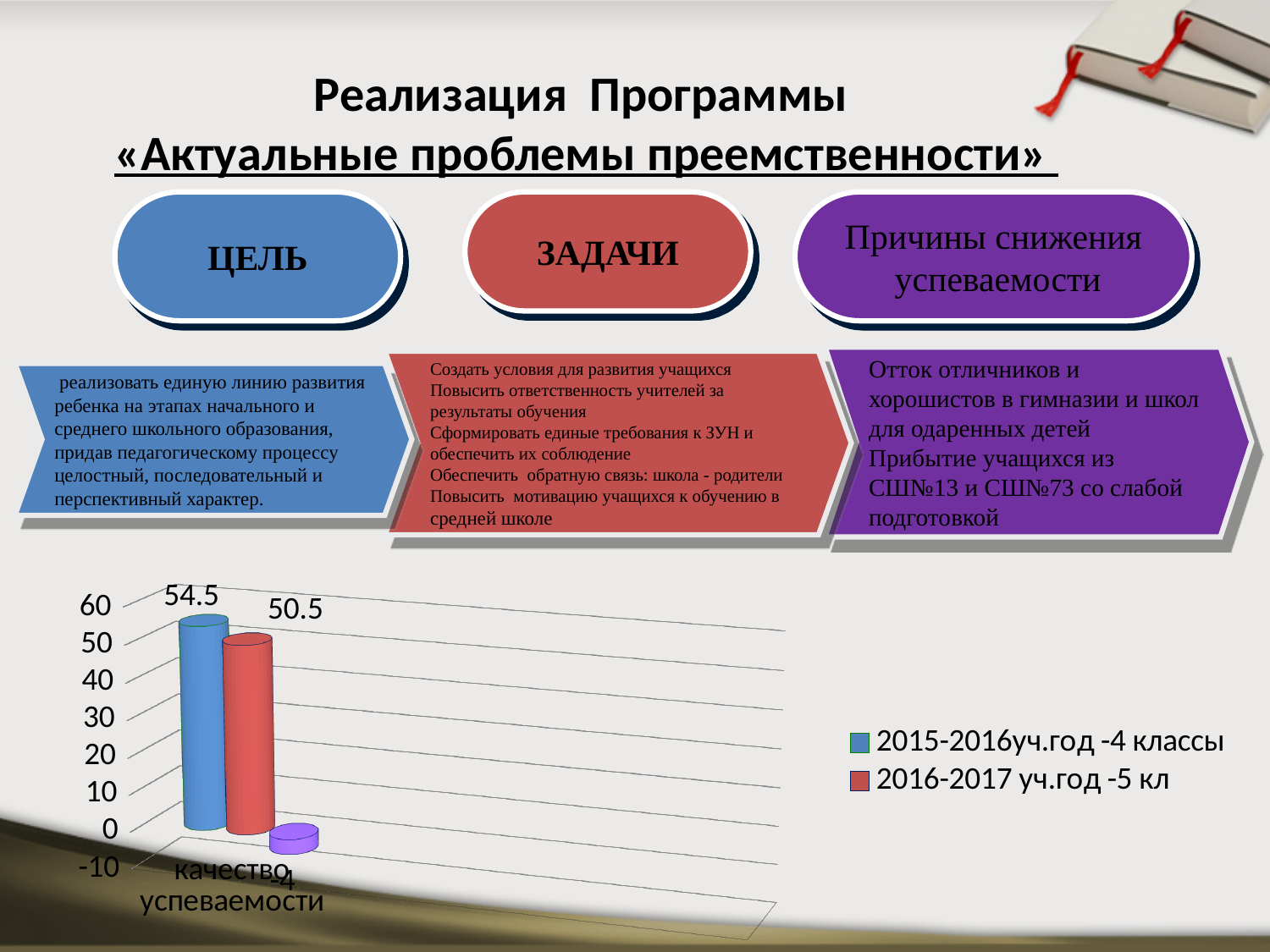
Is the value for "2016-2017 уч.год -5 кл" greater or less than 40? greater How many categories are shown on the x axis of the chart? 1 Which series has the larger value: "2015-2016уч.год -4 классы" or "2016-2017 уч.год -5 кл"? 2015-2016уч.год -4 классы Is the value for "2015-2016уч.год -4 классы" greater or less than 60? less What is the category label shown on the x axis of the chart? качество успеваемости What is the difference between the values for "2015-2016уч.год -4 классы" and "2016-2017 уч.год -5 кл"? 4 Which series in the legend has the highest value in the chart? 2015-2016уч.год -4 классы What kind of chart is shown at the bottom of the slide? bar chart What colour is the bar for the series "2015-2016уч.год -4 классы"? blue What is the value for the series "2015-2016уч.год -4 классы" in the chart? 54.5 How many series does the chart legend list? 2 What is the value for the series "2016-2017 уч.год -5 кл" in the chart? 50.5